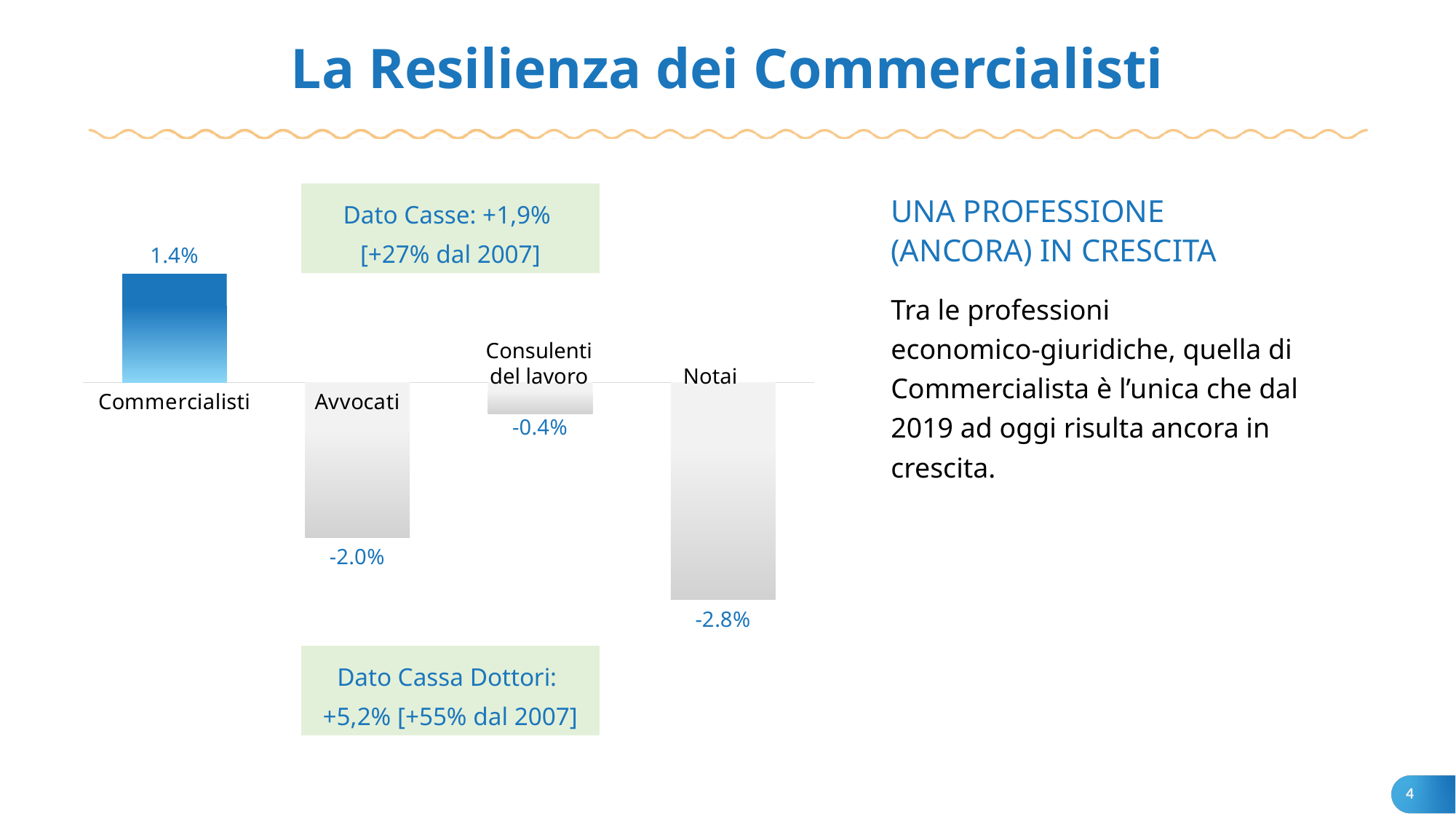
What is the value for Avvocati? -2.0% What is the value for Notai? -2.8% What kind of chart is shown on the slide? Bar chart Which is larger, the value for Avvocati or the value for Consulenti del lavoro? Consulenti del lavoro What is the value for Commercialisti? 1.4% What is the difference between the values for Commercialisti and Notai? 4.2 percentage points Which category has the highest value? Commercialisti Which category has the lowest value? Notai What is the difference between the values for Avvocati and Consulenti del lavoro? 1.6 percentage points How many categories are shown in the chart? 4 What is the value for Consulenti del lavoro? -0.4% Which category's bar is coloured blue rather than grey? Commercialisti